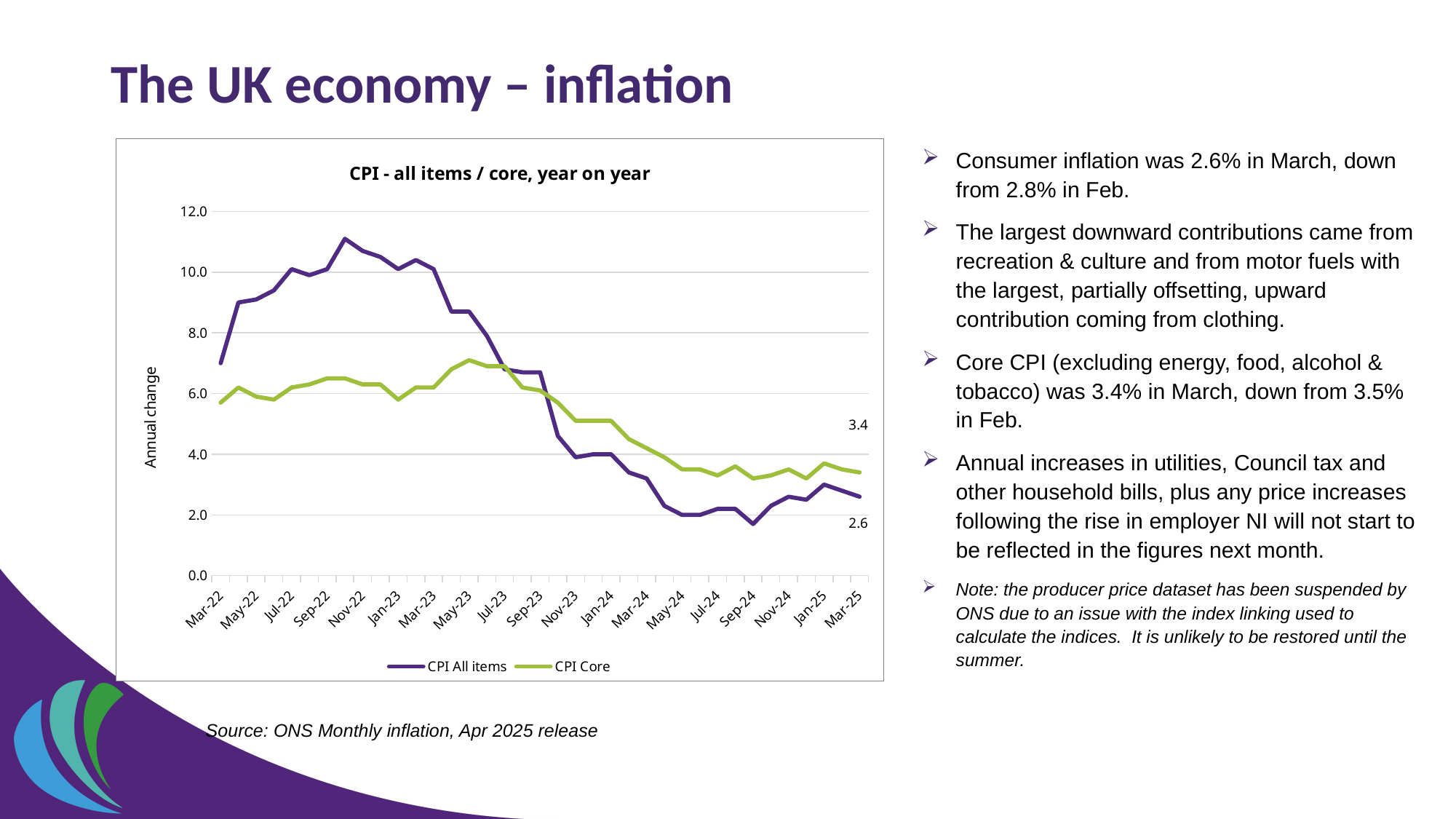
At Mar-25, which series is higher, CPI All items or CPI Core? CPI Core Is the value for CPI Core at Mar-22 greater or less than 4.0? greater What is the value of CPI Core at Mar-25? 3.4 How many series does the chart's legend list? 2 Is the value for CPI All items at Mar-24 greater or less than 4.0? less What is the value of CPI All items at Mar-25? 2.6 What is the title of the chart? CPI - all items / core, year on year What is the difference between CPI Core and CPI All items at Mar-25? 0.8 At Mar-22, which series is higher, CPI All items or CPI Core? CPI All items What kind of chart is shown on the slide? line chart Does CPI All items rise or fall between Mar-23 and Mar-25? fall Is the value for CPI All items at Nov-22 greater or less than 10.0? greater